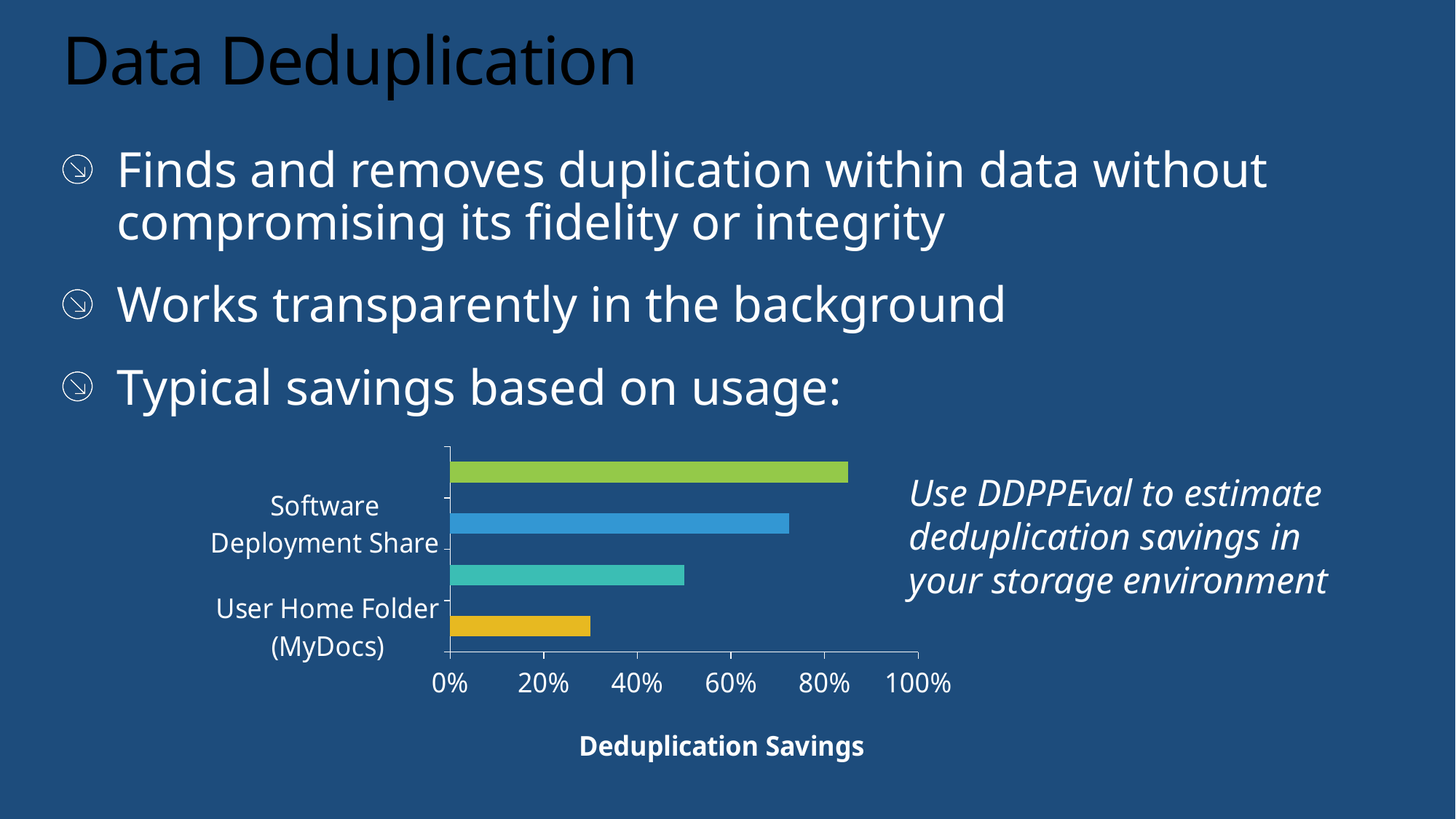
Is the value for User Home Folder (MyDocs) greater or less than 40%? less What kind of chart is shown on the slide? bar chart Which labelled category has the lowest deduplication savings? User Home Folder (MyDocs) What is the title shown below the x axis of the chart? Deduplication Savings Is the value for Software Deployment Share greater or less than 80%? less How many bars are plotted in the chart? 4 Is the value for User Home Folder (MyDocs) greater or less than 20%? greater Which has higher deduplication savings, Software Deployment Share or User Home Folder (MyDocs)? Software Deployment Share What colour is the bar for User Home Folder (MyDocs)? yellow